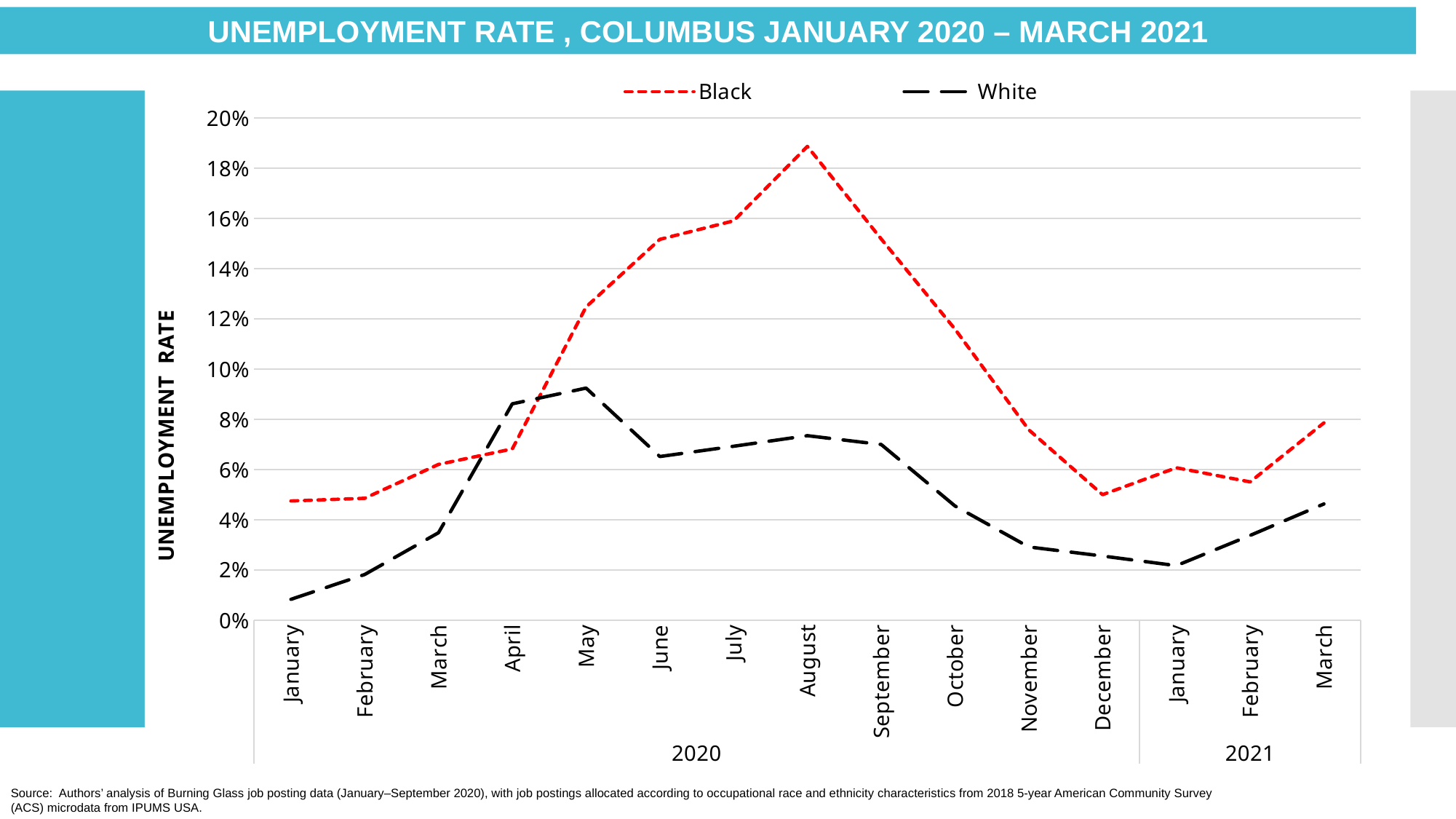
Is the White unemployment rate in January 2020 greater or less than 2%? less Does the Black unemployment rate rise or fall from August 2020 to December 2020? fall In which month does the Black unemployment rate reach its highest value? August 2020 In which month is the White unemployment rate lowest? January 2020 In which month does the White unemployment rate peak? May 2020 Which series is drawn with a red dashed line? Black What type of chart is shown on the slide? line chart In April 2020, which group has the higher unemployment rate, Black or White? White Is the Black unemployment rate in June 2020 greater or less than 14%? greater How many series does the legend list? 2 Is the Black unemployment rate in August 2020 greater or less than 18%? greater How many months are plotted along the x axis? 15